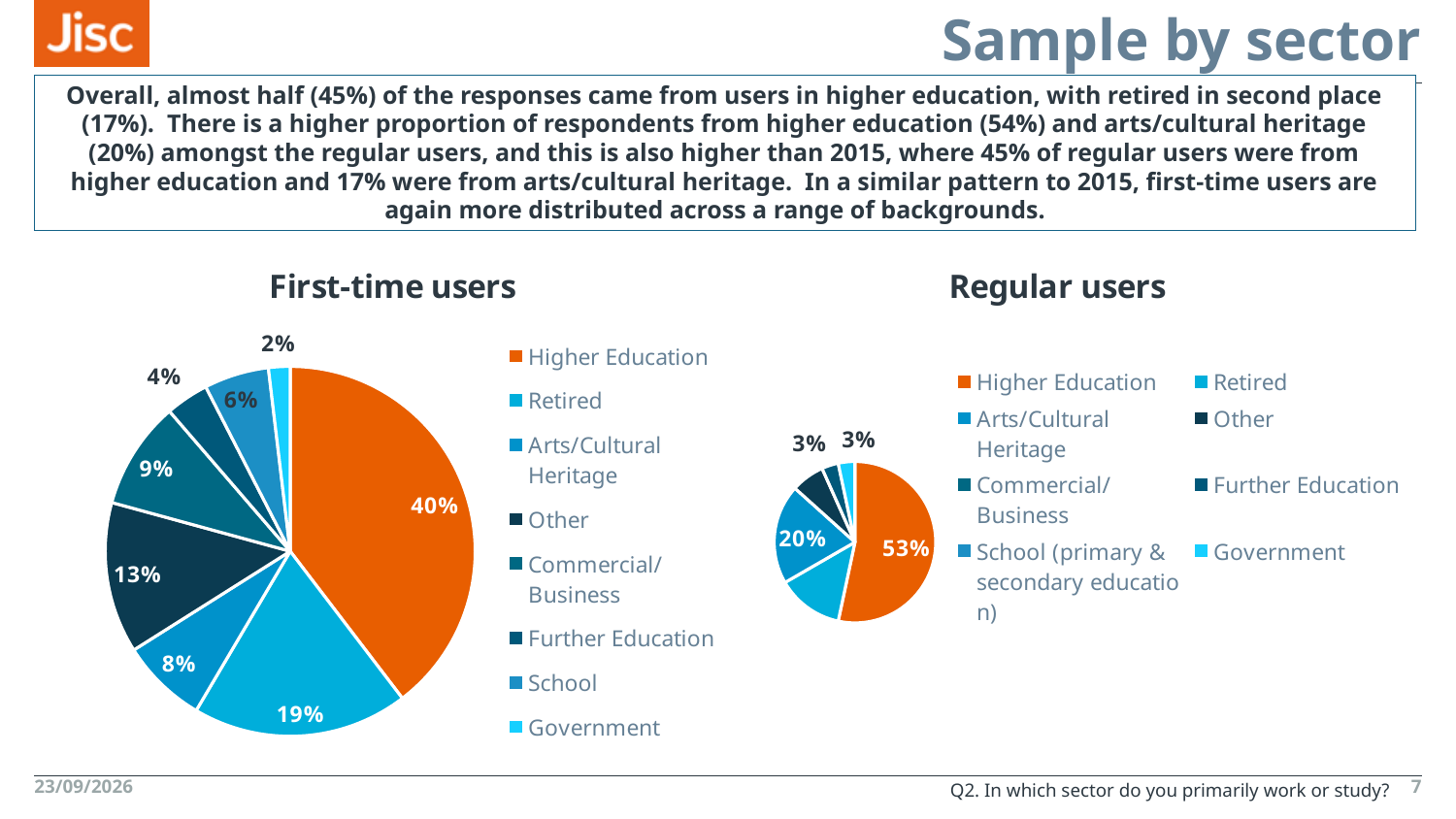
How many sectors are listed in the legend of the First-time users chart? 8 In the Regular users chart, what share of respondents came from Arts/Cultural Heritage? 20% In the First-time users chart, which sector has the smallest slice? Government In the First-time users chart, what percentage of respondents were Retired? 19% In the First-time users chart, what share is labelled for the Other category? 13% In the Regular users chart, which sector has the largest slice? Higher Education In the Regular users chart, what share of respondents came from Higher Education? 53% In the First-time users chart, how many percentage points larger is the Higher Education slice than the Retired slice? 21 percentage points In the First-time users chart, which is larger: the Commercial/Business slice or the Arts/Cultural Heritage slice? Commercial/Business In the First-time users chart, what share of respondents came from Higher Education? 40% What type of chart is used for the First-time users and Regular users data? Pie chart In the First-time users chart, which sector has the largest slice? Higher Education